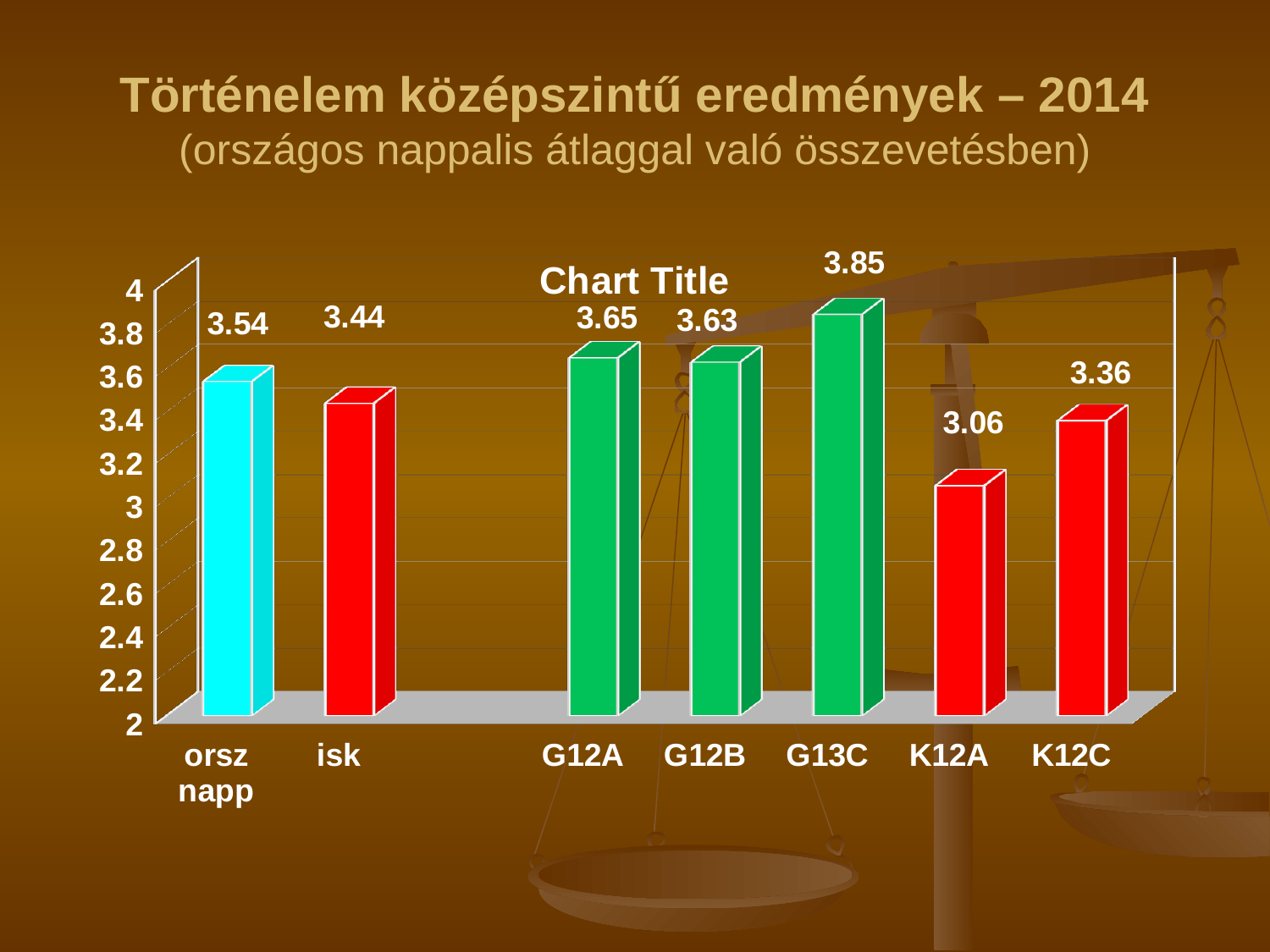
What is the value for G13C? 3.85 What kind of chart is shown on the slide? bar chart What is the value for K12A? 3.06 What is the value for isk? 3.44 Which category has the highest value? G13C How many categories are shown on the x axis? 7 What is the difference between the values for orsz napp and isk? 0.1 Which category has the lowest value? K12A What is the value for orsz napp? 3.54 What is the difference between the values for G13C and K12A? 0.79 Which is larger, the value for G12A or the value for K12C? G12A What is the title printed inside the chart area? Chart Title